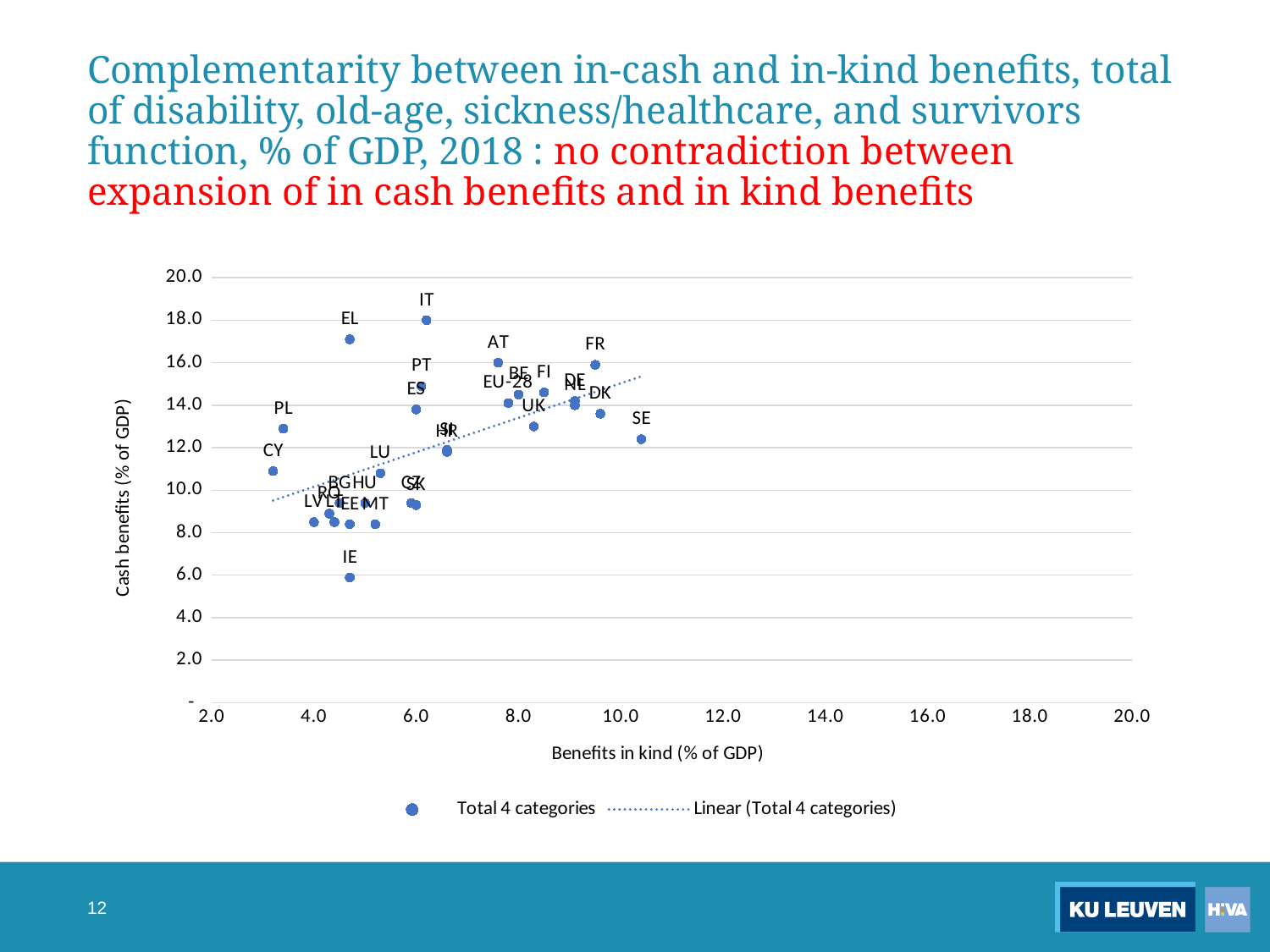
Which has the higher cash benefits value, IT or EL? IT Is the benefits in kind value for CY greater or less than 4.0? less Is the cash benefits value for IT greater or less than 16.0? greater Which country has the lowest cash benefits value in the chart? IE Is the benefits in kind value for SE greater or less than 8.0? greater What is the title of the vertical axis of the chart? Cash benefits (% of GDP) How many entries does the chart legend list? 2 Which country has the highest cash benefits value in the chart? IT Which has the larger benefits in kind value, SE or CY? SE What kind of chart is shown on the slide? Scatter chart What is the title of the horizontal axis of the chart? Benefits in kind (% of GDP)